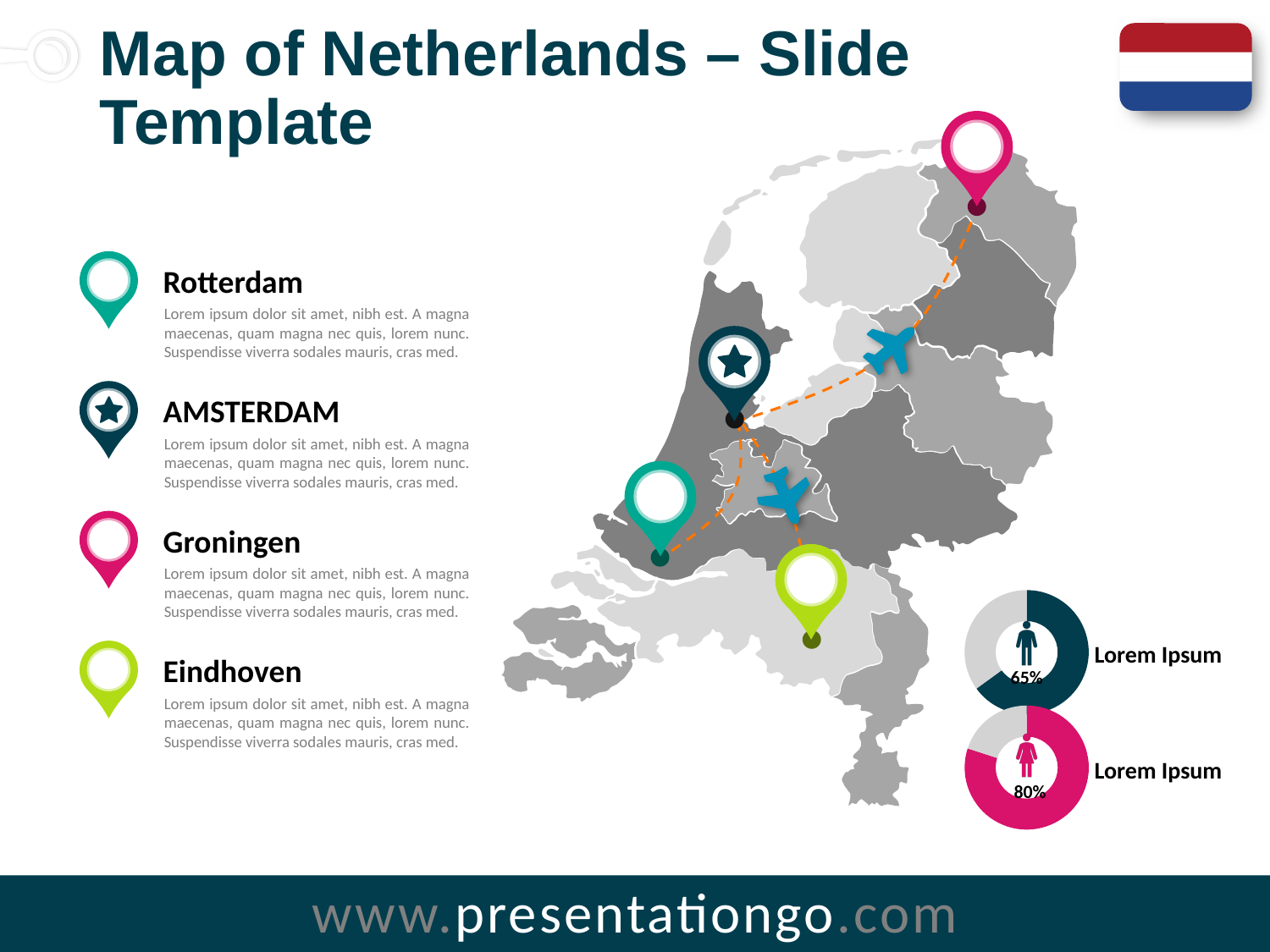
How many donut charts are on the slide? 2 What percentage is shown in the lower donut chart on the right of the slide? 80% Is the value in the lower donut chart greater or less than 90%? less What percentage is shown in the upper donut chart on the right of the slide? 65% Which donut chart shows the larger percentage, the upper one or the lower one? The lower one What colour is the filled portion of the lower donut chart showing 80%? Pink What is the difference between the percentages shown in the lower and upper donut charts? 15% Is the value in the upper donut chart greater or less than 50%? greater What label appears next to each donut chart on the slide? Lorem Ipsum What kind of chart is used to display the 65% and 80% values on the slide? Donut chart